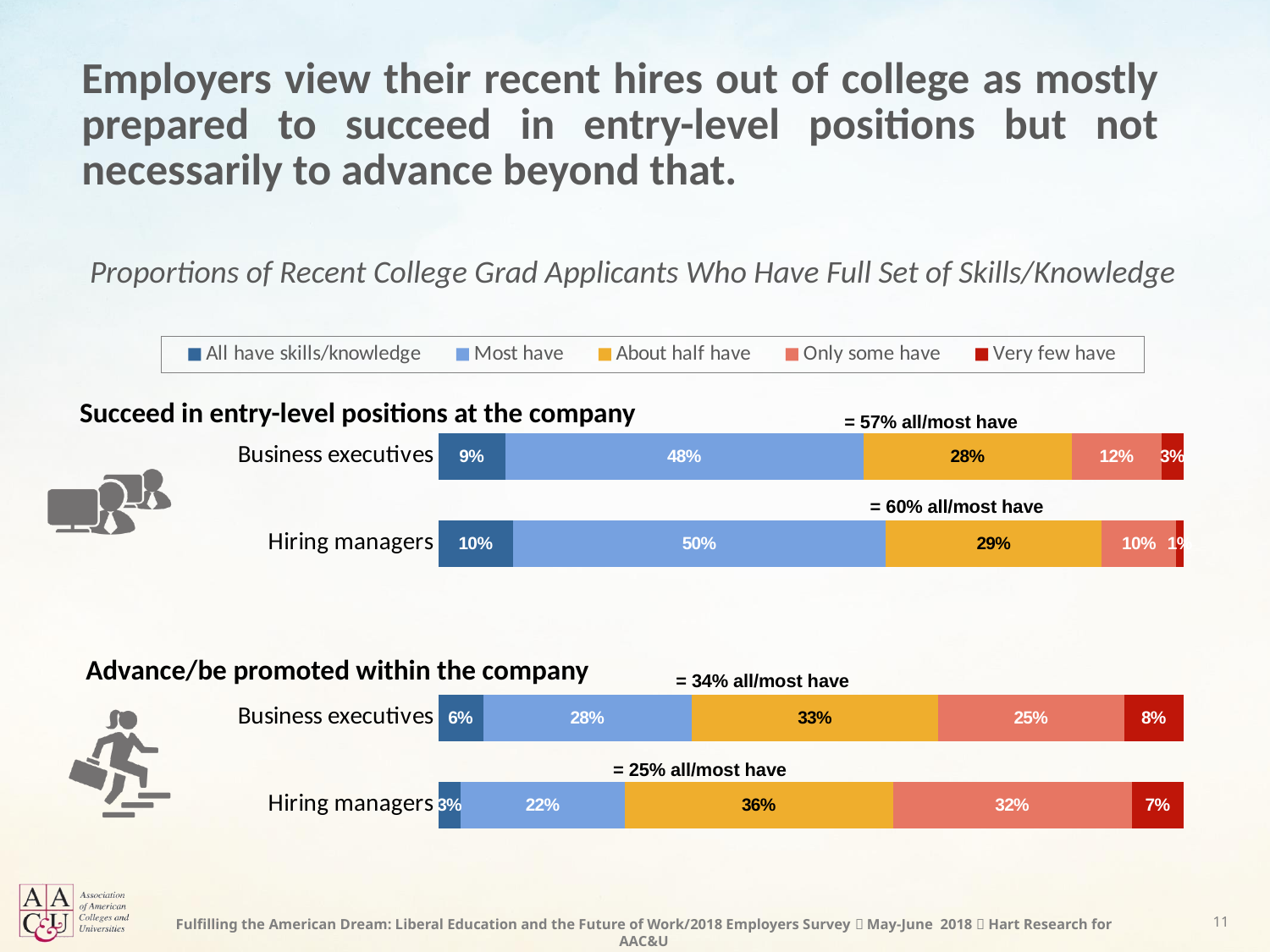
In the 'Succeed in entry-level positions at the company' chart, what percentage of hiring managers say 'About half have'? 29% In the 'Succeed in entry-level positions at the company' chart, what is the difference between the 'Most have' percentages for hiring managers and business executives? 2% In the 'Succeed in entry-level positions at the company' chart, what percentage of business executives say 'Most have'? 48% In the 'Advance/be promoted within the company' chart, which group has a larger 'Only some have' percentage, business executives or hiring managers? Hiring managers In the 'Advance/be promoted within the company' chart, which response category is the largest for hiring managers? About half have In the 'Advance/be promoted within the company' chart, what is the combined 'all/most have' percentage for business executives? 34% In the 'Succeed in entry-level positions at the company' chart, which response category is the smallest for business executives? Very few have How many series does the legend list? 5 What kind of chart is used on this slide? Stacked bar chart In the 'Advance/be promoted within the company' chart, what percentage of business executives say 'Very few have'? 8% Which colour represents 'About half have' in the legend? Orange/yellow In the 'Advance/be promoted within the company' chart, what percentage of hiring managers say 'Only some have'? 32%